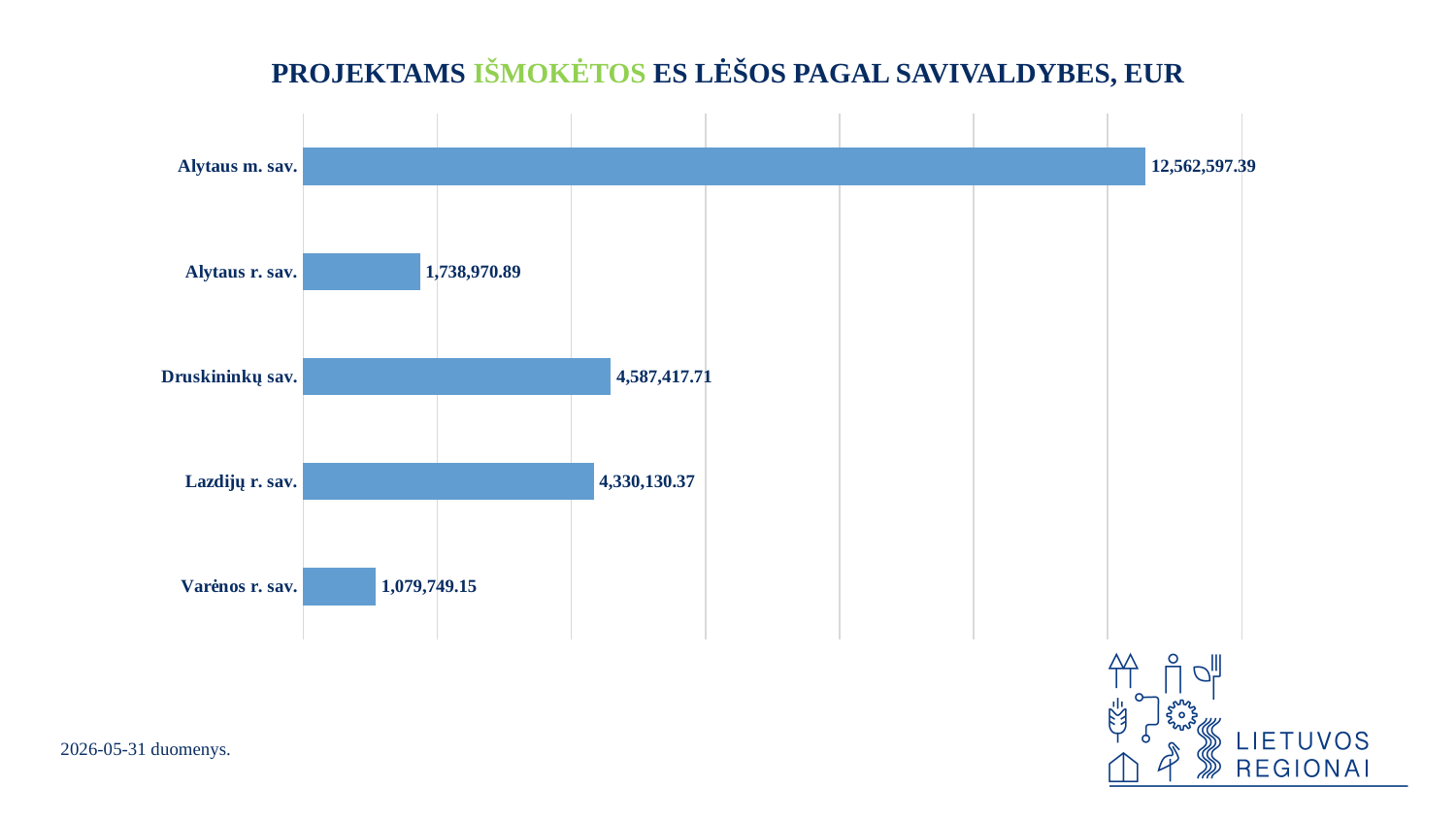
What is the title of the chart? PROJEKTAMS IŠMOKĖTOS ES LĖŠOS PAGAL SAVIVALDYBES, EUR Which municipality has the highest value? Alytaus m. sav. What is the difference between the values for Druskininkų sav. and Lazdijų r. sav.? 257,287.34 Which is larger, the value for Druskininkų sav. or Lazdijų r. sav.? Druskininkų sav. What kind of chart is shown on the slide? Bar chart What is the value for Varėnos r. sav.? 1,079,749.15 Which municipality has the lowest value? Varėnos r. sav. What is the value for Druskininkų sav.? 4,587,417.71 How many municipalities are shown in the chart? 5 What is the value for Alytaus m. sav.? 12,562,597.39 What is the difference between the values for Alytaus r. sav. and Varėnos r. sav.? 659,221.74 What is the value for Lazdijų r. sav.? 4,330,130.37